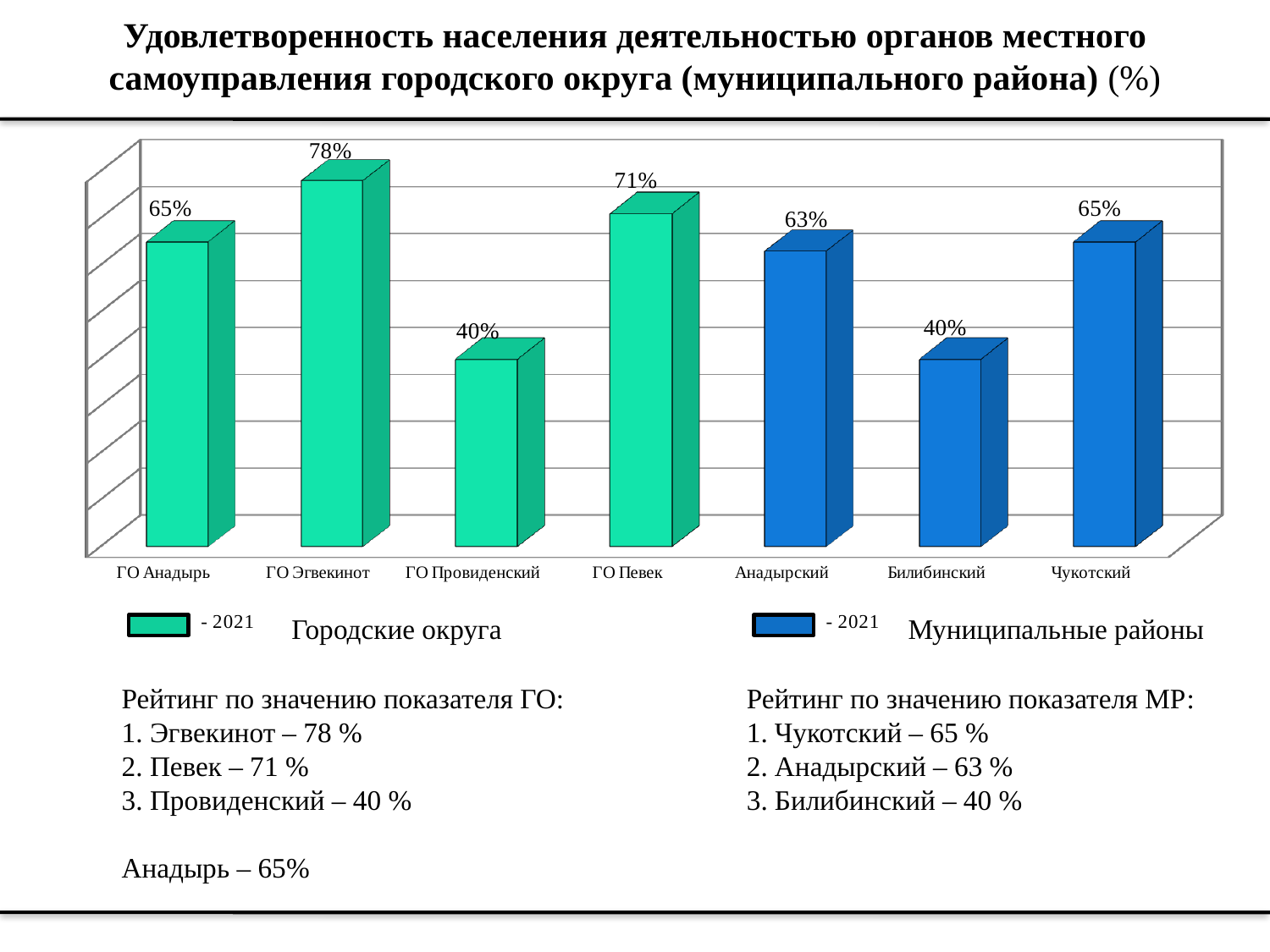
What kind of chart is shown on the slide? bar chart What is the value for ГО Эгвекинот? 78% What is the difference between the values for ГО Эгвекинот and ГО Певек? 7% What is the value for Билибинский? 40% What is the difference between the values for Чукотский and Анадырский? 2% What is the value for ГО Певек? 71% How many entries does the legend list? 2 Which is larger, the value for ГО Анадырь or the value for ГО Провиденский? ГО Анадырь What is the value for Анадырский? 63% Which category has the highest value? ГО Эгвекинот How many categories are shown on the x axis? 7 Which is larger, the value for Анадырский or the value for Чукотский? Чукотский